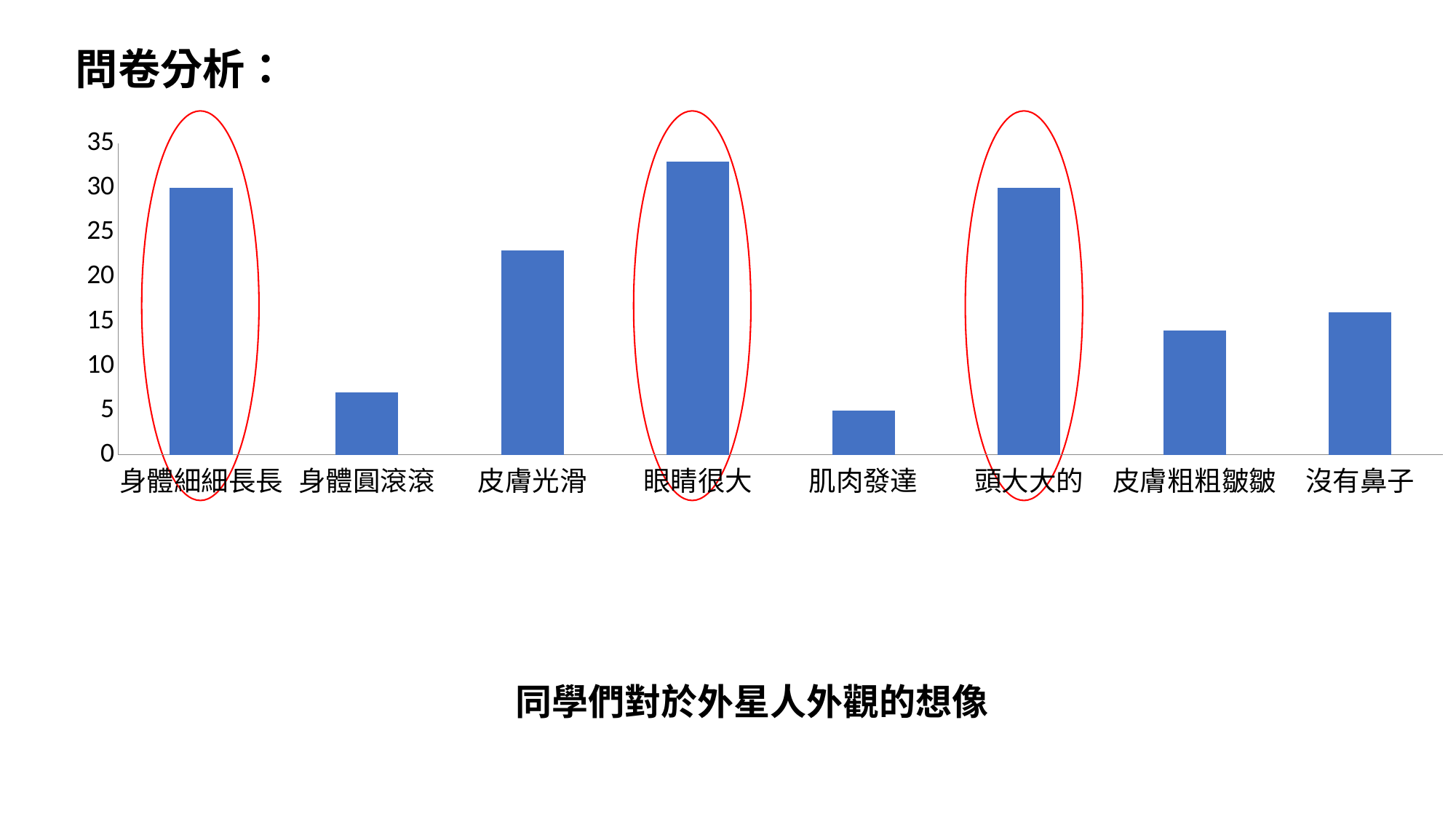
Is the value for 皮膚光滑 greater or less than 20? greater Is the value for 沒有鼻子 greater or less than 20? less Which is larger, the value for 身體圓滾滾 or the value for 皮膚粗粗皺皺? 皮膚粗粗皺皺 How many categories are shown on the x axis of the chart? 8 How many bars in the chart are circled in red? 3 Which category has the lowest bar in the chart? 肌肉發達 Is the value for 眼睛很大 greater or less than 30? greater Which is larger, the value for 皮膚光滑 or the value for 沒有鼻子? 皮膚光滑 Which category has the highest bar in the chart? 眼睛很大 What is the caption shown below the chart? 同學們對於外星人外觀的想像 What kind of chart is shown on the slide? bar chart